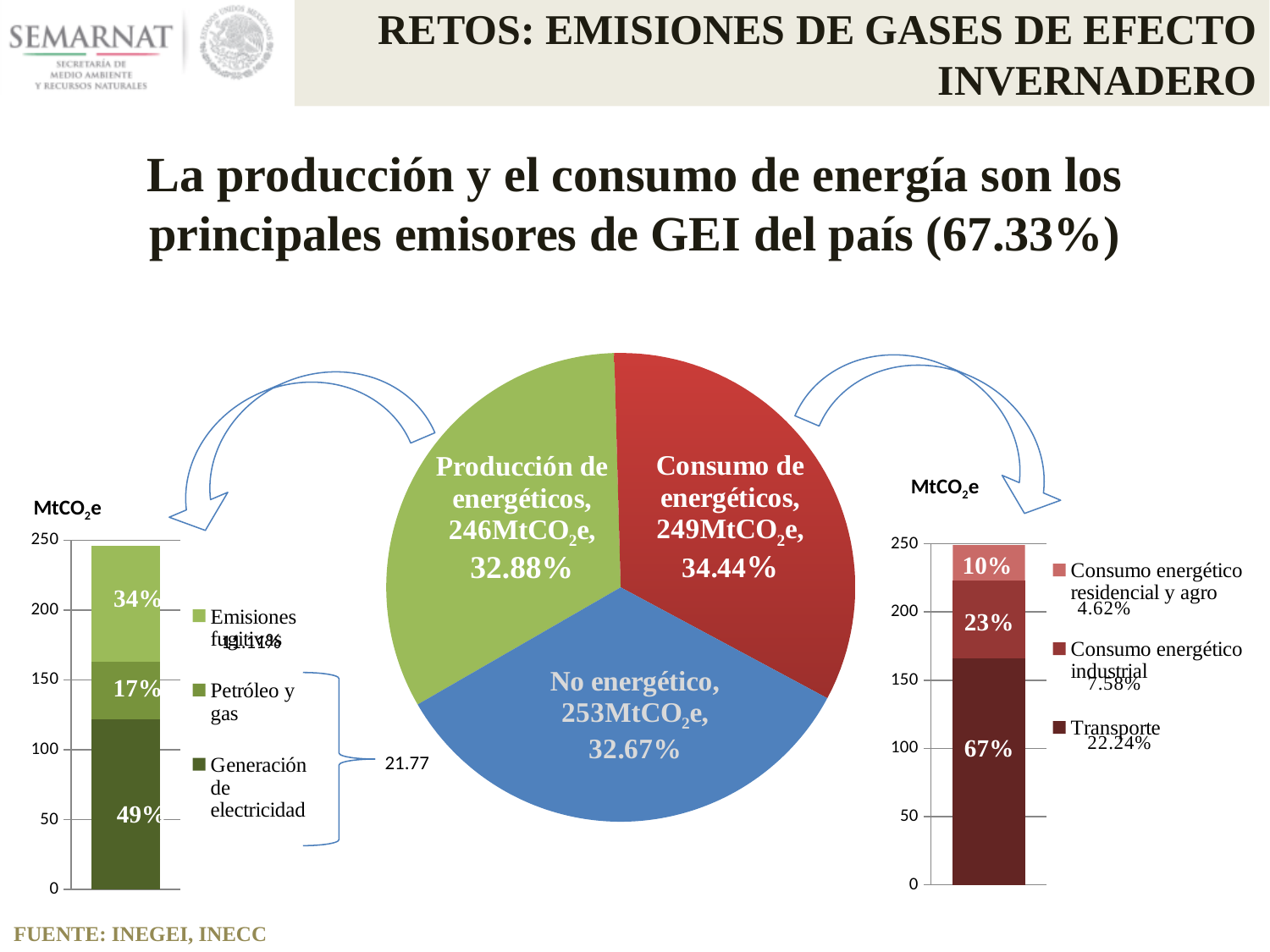
In the central pie chart, which slice has the smallest printed MtCO2e value? Producción de energéticos In the left stacked bar chart, what percentage is shown for Generación de electricidad? 49% In the central pie chart, which slice has the largest printed MtCO2e value? No energético In the central pie chart, what percentage share is shown for No energético? 32.67% In the central pie chart, what is the difference in MtCO2e between No energético and Producción de energéticos? 7 How many series does the legend of the right stacked bar chart list? 3 In the left stacked bar chart, which segment has the smallest percentage? Petróleo y gas How many slices does the central pie chart have? 3 In the central pie chart, what percentage share is shown for Consumo de energéticos? 34.44% In the central pie chart, what is the emission value shown for Producción de energéticos? 246MtCO2e In the right stacked bar chart, is the total height of the stacked bar greater or less than 200? greater In the right stacked bar chart, what percentage is shown for Transporte? 67%